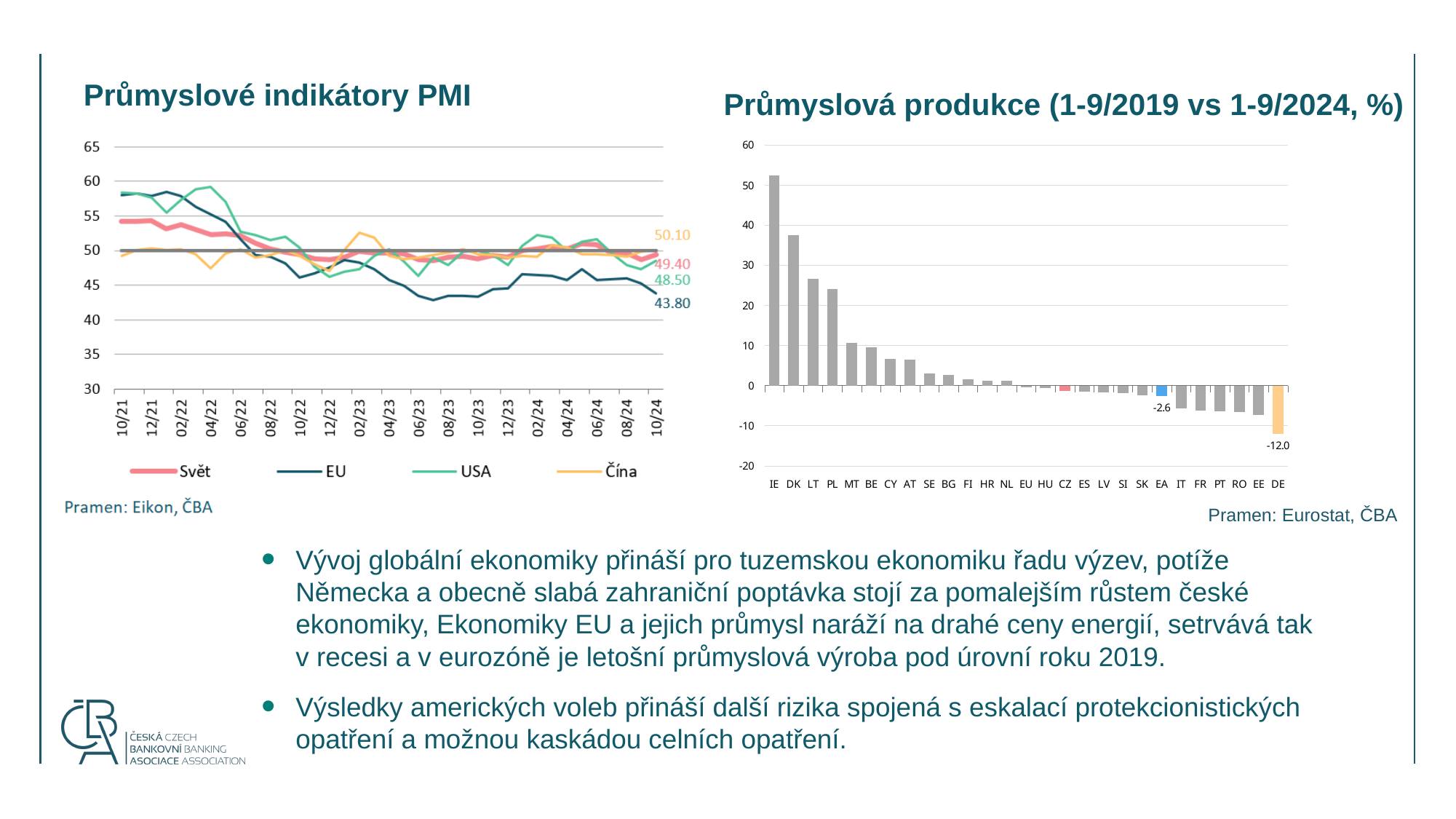
In the 'Průmyslové indikátory PMI' chart, what is the latest labelled value for Čína? 50.10 What kind of chart is the 'Průmyslové indikátory PMI' chart on the left? line chart In the 'Průmyslová produkce' chart, is the value for IE greater or less than 50? greater In the 'Průmyslová produkce' chart, what is the labelled value for DE? -12.0 In the 'Průmyslové indikátory PMI' chart, what is the latest labelled value for EU? 43.80 What kind of chart is the 'Průmyslová produkce (1-9/2019 vs 1-9/2024, %)' chart on the right? bar chart In the 'Průmyslová produkce' chart, which country has the lowest value? DE How many series does the legend of the 'Průmyslové indikátory PMI' chart list? 4 In the 'Průmyslové indikátory PMI' chart, what is the difference between the latest labelled values for Čína and EU? 6.30 In the 'Průmyslová produkce' chart, which country has the highest value? IE In the 'Průmyslové indikátory PMI' chart, does the EU line overall rise or fall from 10/21 to 10/24? fall In the 'Průmyslové indikátory PMI' chart, what is the latest labelled value for Svět? 49.40